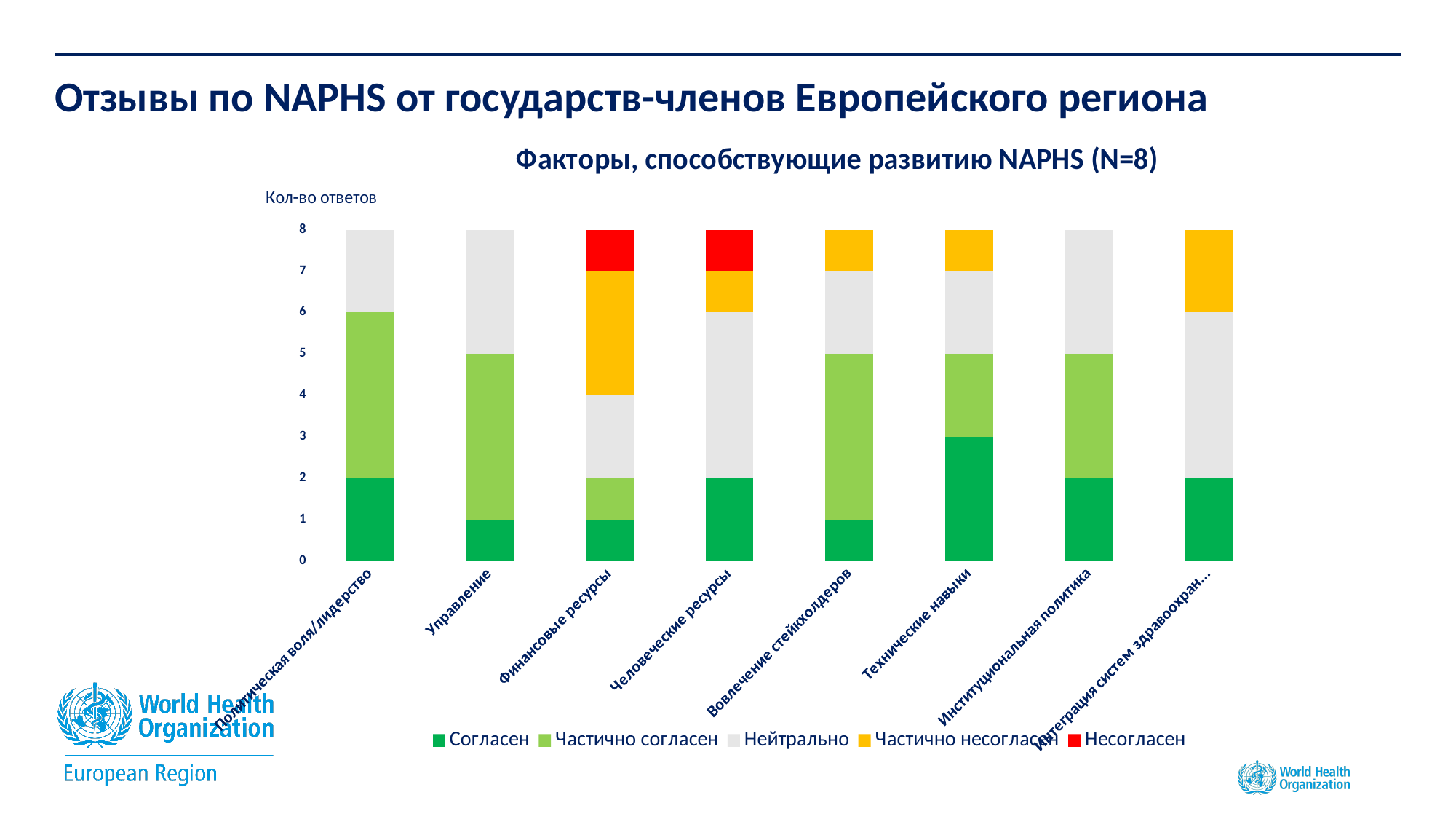
What is the total height of the stacked bar for Управление? 8 What is the value of the Согласен segment for Технические навыки? 3 What is the title of the chart? Факторы, способствующие развитию NAPHS (N=8) How many categories are shown along the x axis of the chart? 8 Which legend entry is shown in red? Несогласен What kind of chart is shown on the slide? Stacked bar chart How many series does the legend list? 5 What is the difference between the Согласен segment for Технические навыки and the Согласен segment for Управление? 2 Which is larger: the Частично согласен segment for Политическая воля/лидерство or for Институциональная политика? Политическая воля/лидерство What is the value of the Нейтрально segment for Человеческие ресурсы? 4 Which category has the largest Согласен segment? Технические навыки What is the value of the Частично несогласен segment for Финансовые ресурсы? 3